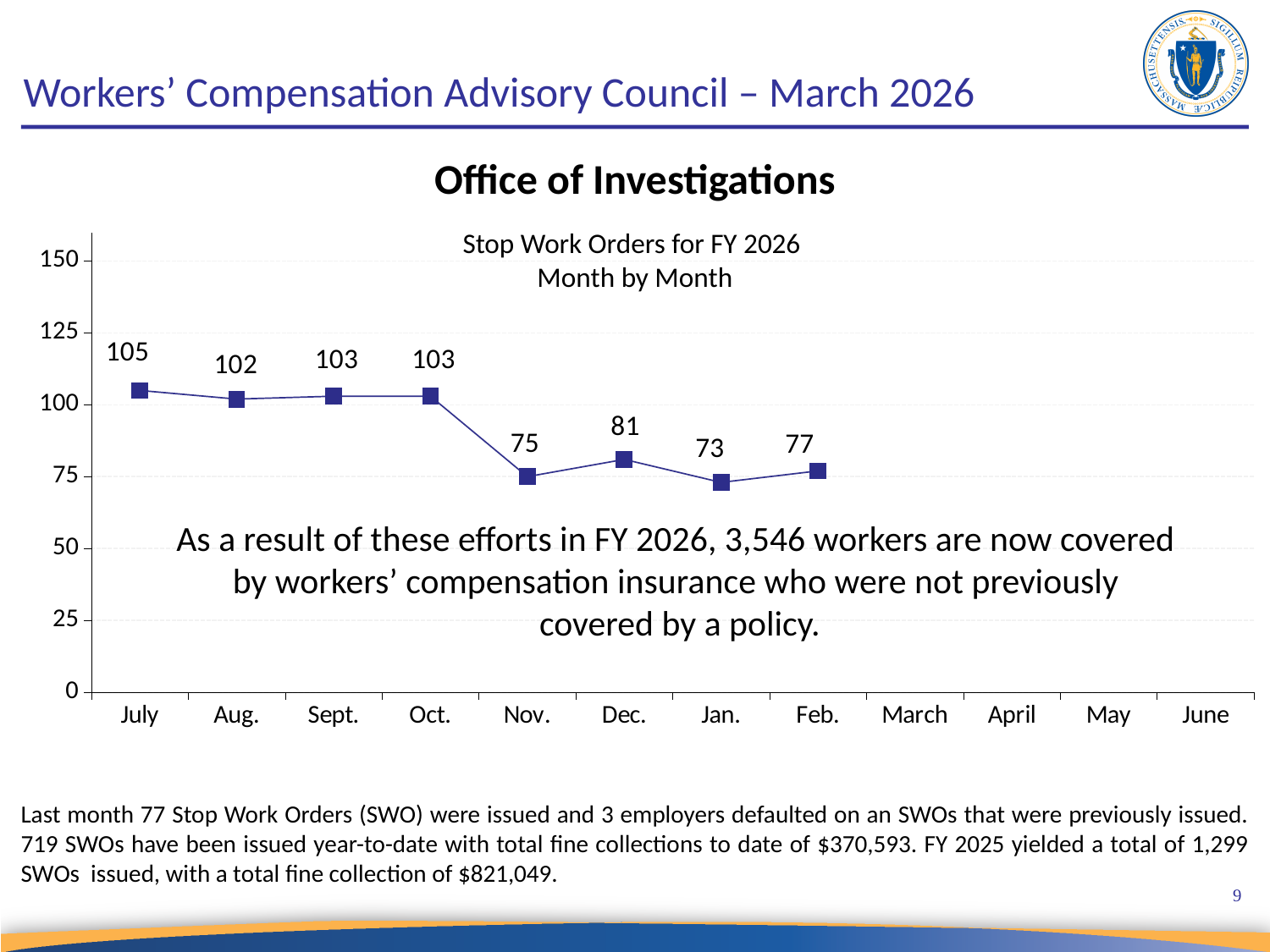
What is the value for November in the Stop Work Orders chart? 75 What is the difference between the values for October and November? 28 Which month has the lowest number of Stop Work Orders? Jan. How many months have a plotted data point in the chart? 8 Which month has the highest number of Stop Work Orders? July What kind of chart is shown on the slide? line chart What is the value for July in the Stop Work Orders chart? 105 Which is larger, the value for December or the value for February? December Do the values generally rise or fall from July to February? fall Is the value for January greater or less than 100? less What is the value for December in the Stop Work Orders chart? 81 What is the title of the chart? Stop Work Orders for FY 2026 Month by Month